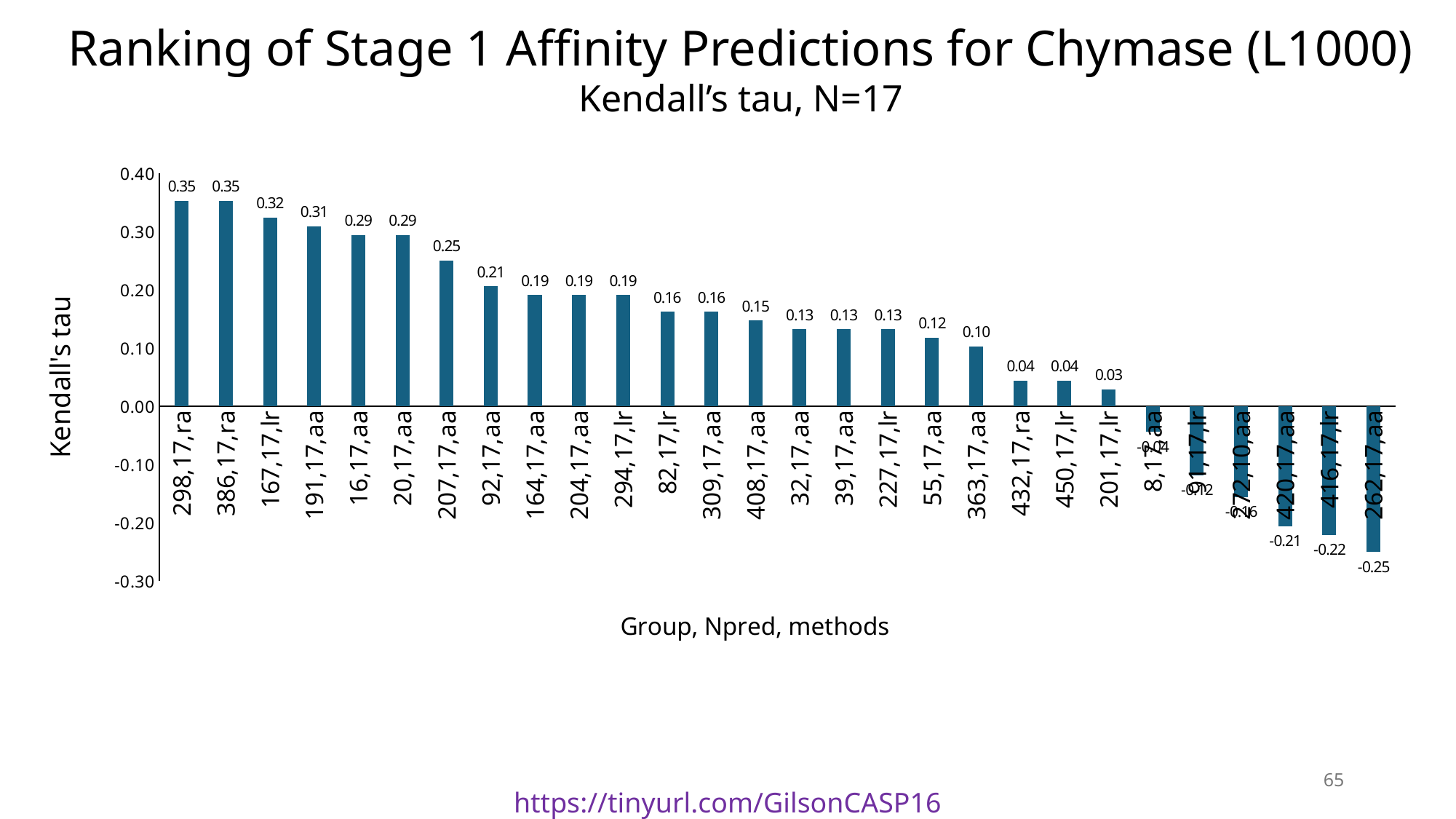
What is the highest Kendall's tau value shown on the chart? 0.35 Which has a higher Kendall's tau, 191,17,aa or 408,17,aa? 191,17,aa What is the Kendall's tau value for 167,17,lr? 0.32 What is the Kendall's tau value for 420,17,aa? -0.21 What is the difference between the Kendall's tau for 298,17,ra and for 92,17,aa? 0.14 Which group has the lowest Kendall's tau? 262,17,aa What is the Kendall's tau value for 207,17,aa? 0.25 What is the Kendall's tau value for 363,17,aa? 0.10 Is the value for 416,17,lr greater or less than -0.20? less What kind of chart is shown on the slide? bar chart Do the Kendall's tau values rise or fall from left to right along the x axis? fall How many bars are plotted on the chart? 28